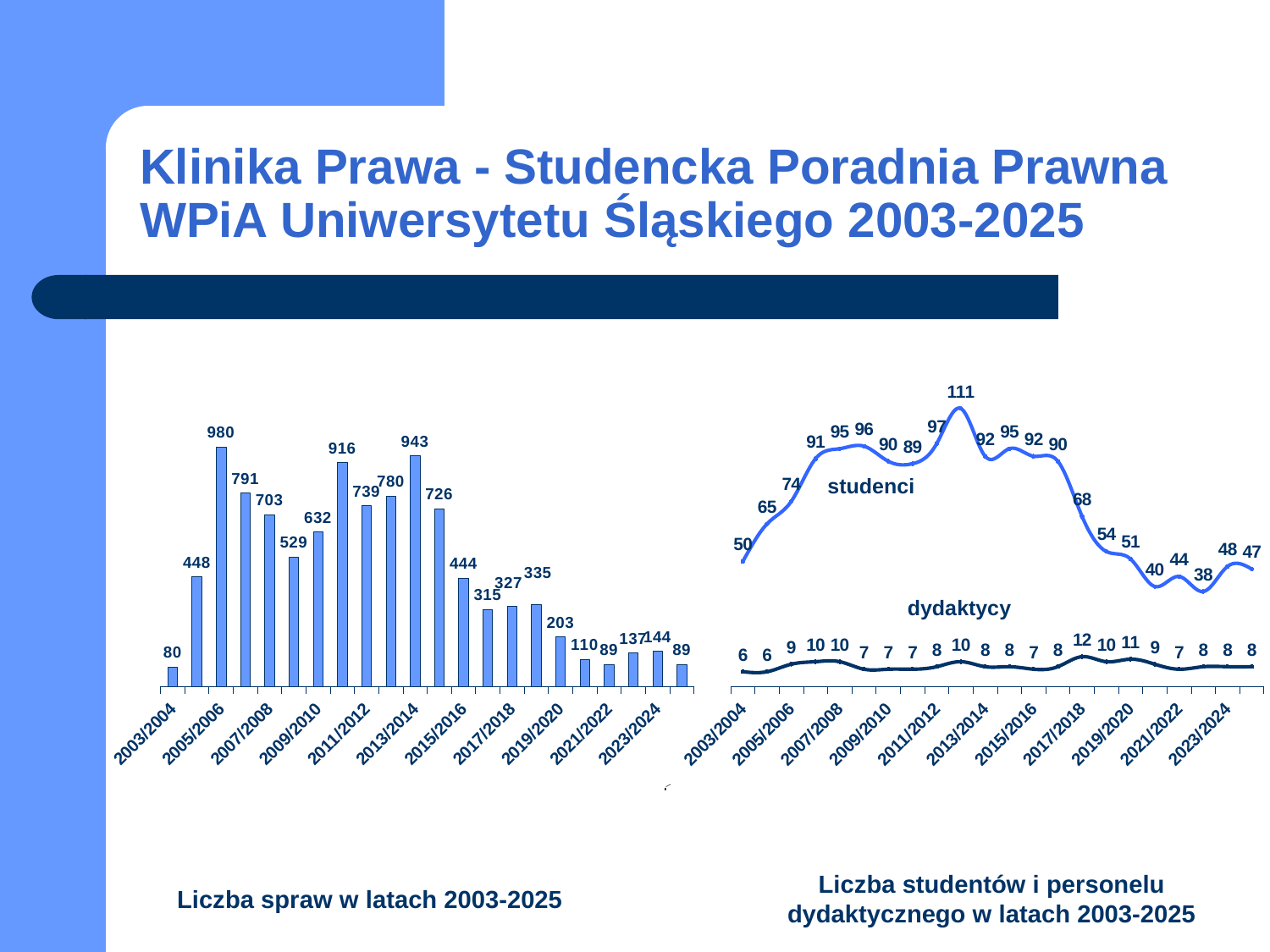
In the left chart 'Liczba spraw w latach 2003-2025', which is larger: the value for 2003/2004 or the value for 2023/2024? 2023/2024 In the right chart 'Liczba studentów i personelu dydaktycznego w latach 2003-2025', what is the highest value of the 'studenci' series? 111 In the left chart 'Liczba spraw w latach 2003-2025', what is the lowest value shown? 80 In the right chart 'Liczba studentów i personelu dydaktycznego w latach 2003-2025', what is the 'studenci' value for 2003/2004? 50 What kind of chart is the left chart, 'Liczba spraw w latach 2003-2025'? bar chart In the left chart 'Liczba spraw w latach 2003-2025', what is the difference between the highest value (980) and the value for 2013/2014 (943)? 37 In the right chart 'Liczba studentów i personelu dydaktycznego w latach 2003-2025', what is the lowest value of the 'studenci' series? 38 In the left chart 'Liczba spraw w latach 2003-2025', what is the value for 2013/2014? 943 In the right chart 'Liczba studentów i personelu dydaktycznego w latach 2003-2025', what is the highest value of the 'dydaktycy' series? 12 How many bars are plotted in the left chart 'Liczba spraw w latach 2003-2025'? 22 In the left chart 'Liczba spraw w latach 2003-2025', what is the highest value shown? 980 How many series are plotted in the right chart 'Liczba studentów i personelu dydaktycznego w latach 2003-2025'? 2